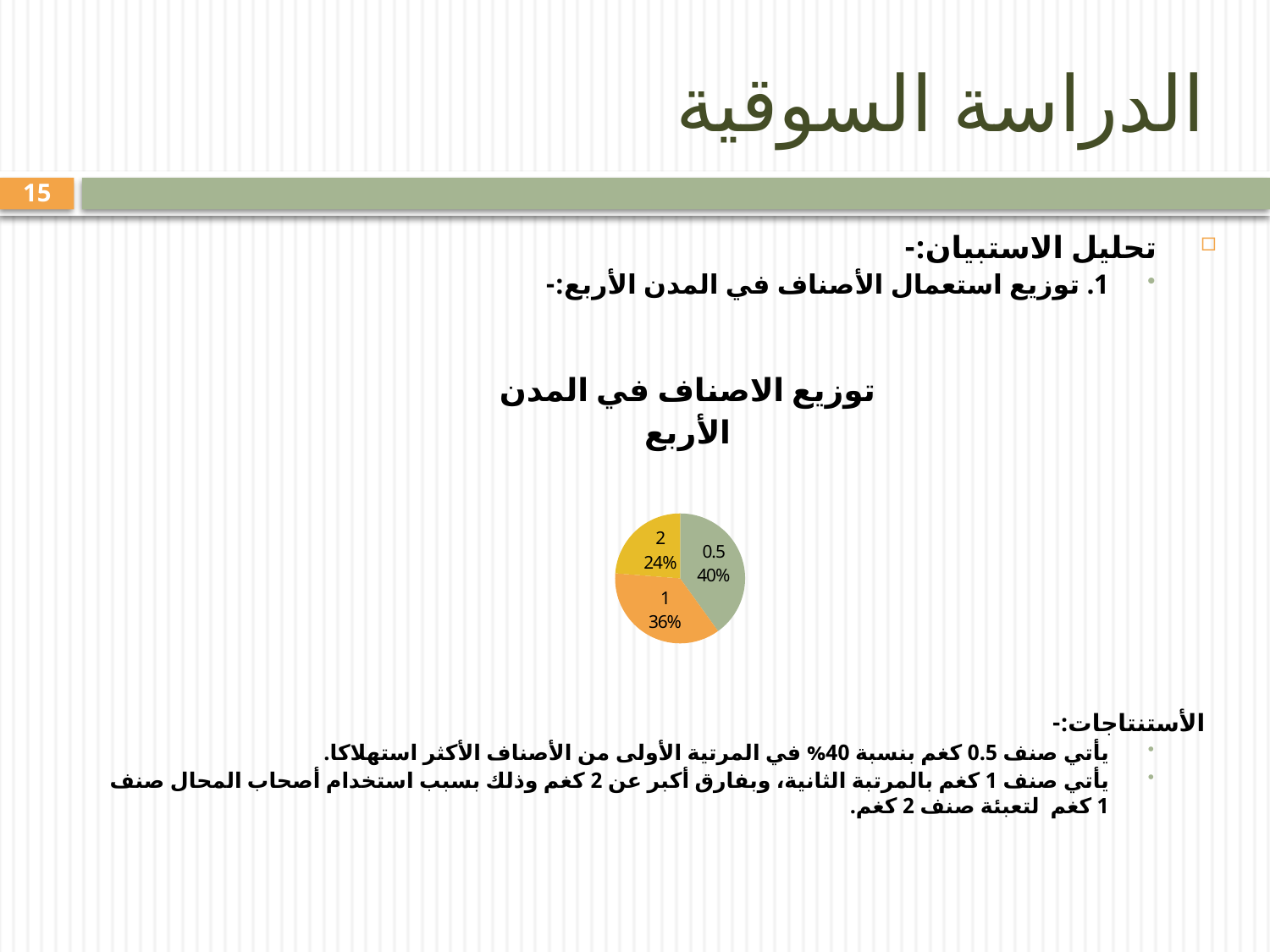
What is the share of the 0.5 slice in the pie chart? 40% Which category has the largest share in the pie chart? 0.5 What is the title of the pie chart? توزيع الاصناف في المدن الأربع Which category has the smallest share in the pie chart? 2 What kind of chart is shown on the slide? pie chart What is the difference in percentage points between the 1 slice and the 2 slice? 12 What is the share of the 1 slice in the pie chart? 36% What colour is the 0.5 slice in the pie chart? grey-green How many slices does the pie chart have? 3 What is the difference in percentage points between the 0.5 slice and the 1 slice? 4 Which slice is larger, 1 or 2? 1 What is the share of the 2 slice in the pie chart? 24%